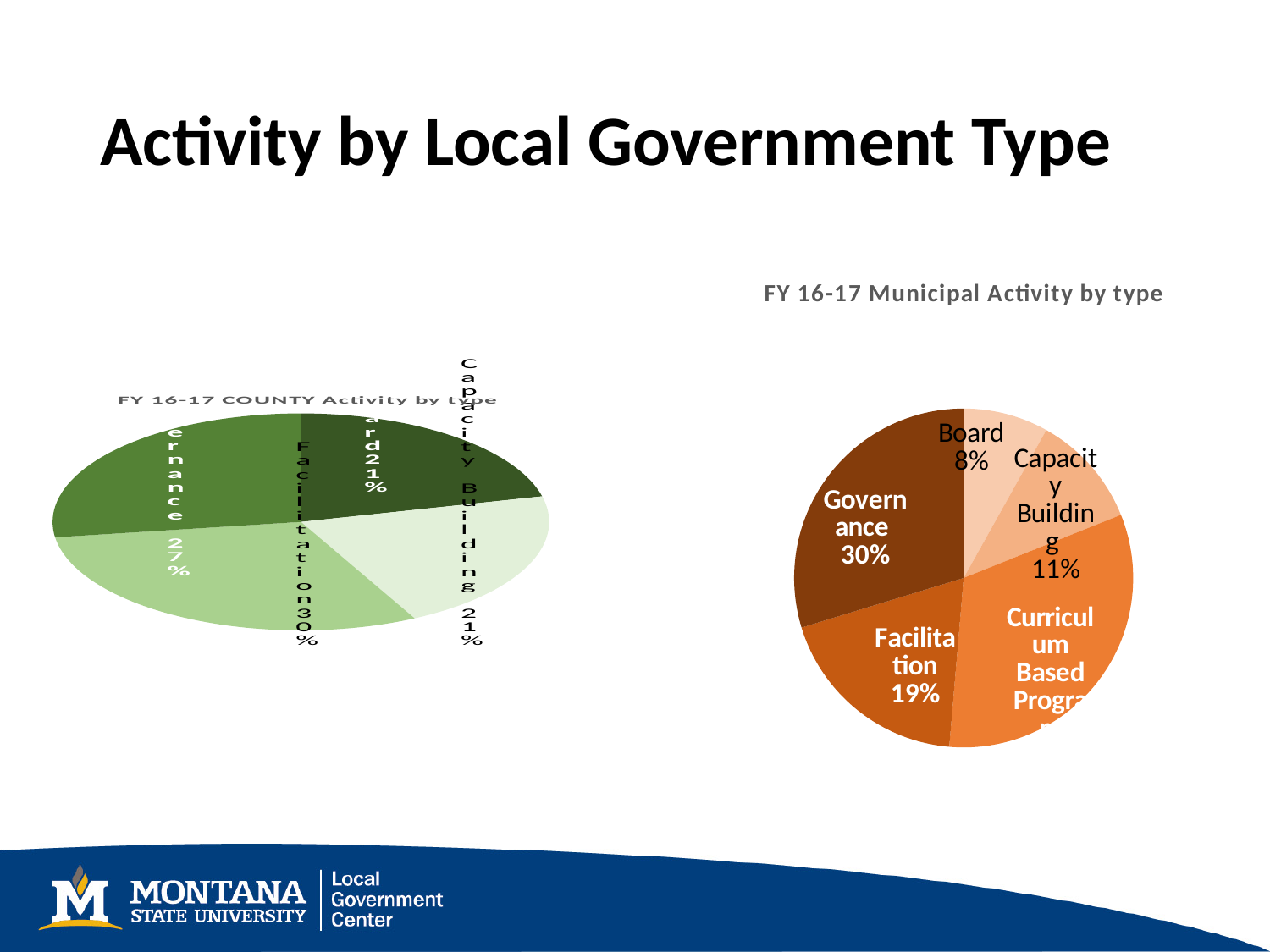
In the FY 16-17 COUNTY Activity by type chart, which category has the largest slice? Facilitation In the FY 16-17 Municipal Activity by type chart, how many percentage points larger is Governance than Facilitation? 11 percentage points In the FY 16-17 Municipal Activity by type chart, what share is Board? 8% In the FY 16-17 Municipal Activity by type chart, what share is Facilitation? 19% In the FY 16-17 Municipal Activity by type chart, what share is Capacity Building? 11% What kind of chart is the FY 16-17 Municipal Activity by type chart? Pie chart In the FY 16-17 Municipal Activity by type chart, what share is Governance? 30% In the FY 16-17 COUNTY Activity by type chart, what share is Facilitation? 30% In the FY 16-17 Municipal Activity by type chart, how many slices does the pie have? 5 In the FY 16-17 COUNTY Activity by type chart, what share is Governance? 27% In the FY 16-17 Municipal Activity by type chart, which category has the smallest slice? Board In the FY 16-17 Municipal Activity by type chart, which is larger, Capacity Building or Board? Capacity Building